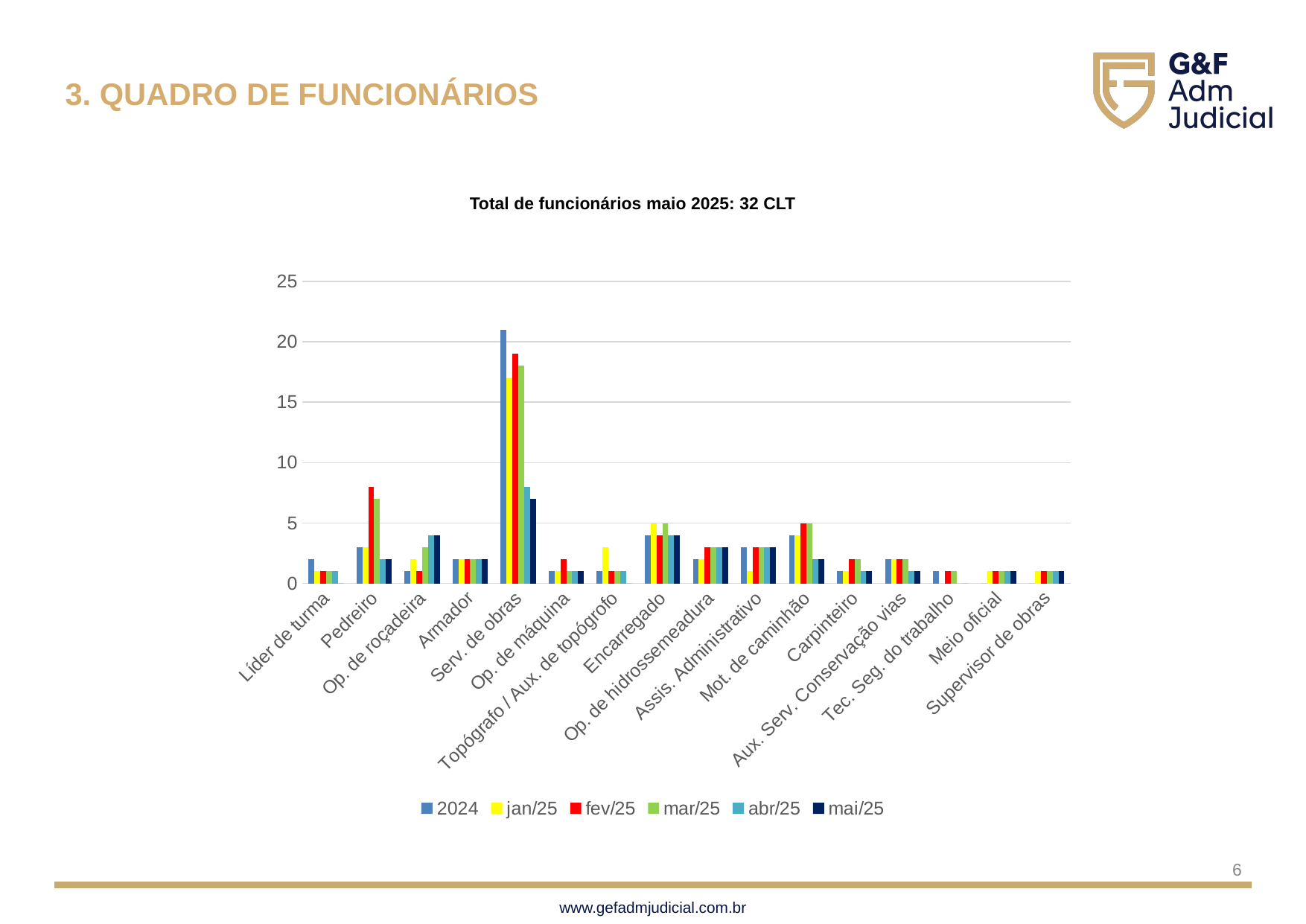
For Pedreiro, which is larger: the 2024 value or the fev/25 value? fev/25 Is the mai/25 value for Mot. de caminhão greater or less than 5? less Is the mai/25 value for Serv. de obras greater or less than 10? less How many job categories are shown on the x axis? 16 How many series does the legend list? 6 What kind of chart is shown on the slide? bar chart Which category has the highest bar in the chart? Serv. de obras Is the 2024 value for Serv. de obras greater or less than 20? greater What is the title shown above the chart? Total de funcionários maio 2025: 32 CLT Which series is listed first in the legend? 2024 For Serv. de obras, which is larger: the 2024 value or the mai/25 value? 2024